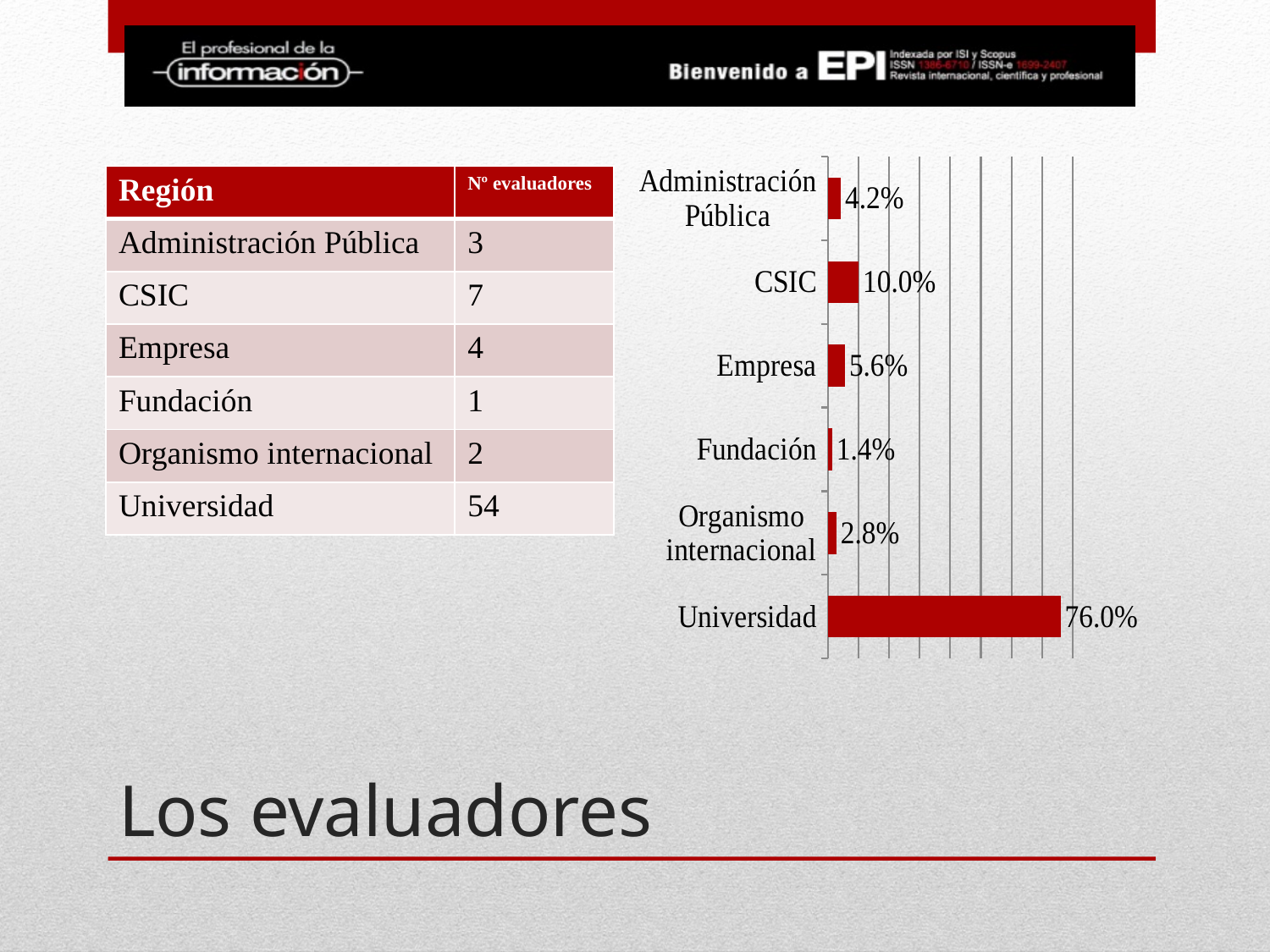
What is the difference between the percentages for Universidad and CSIC in the bar chart? 66.0% What percentage does the bar chart show for Organismo internacional? 2.8% What is the difference between the percentages for CSIC and Empresa in the bar chart? 4.4% What percentage does the bar chart show for CSIC? 10.0% In the bar chart, which is larger: Administración Pública or Empresa? Empresa What colour are the bars in the chart? Dark red How many categories are shown in the bar chart? 6 Which category has the highest value in the bar chart? Universidad What percentage does the bar chart show for Fundación? 1.4% Which category has the lowest value in the bar chart? Fundación What kind of chart is shown on the slide? Bar chart What percentage does the bar chart show for Universidad? 76.0%